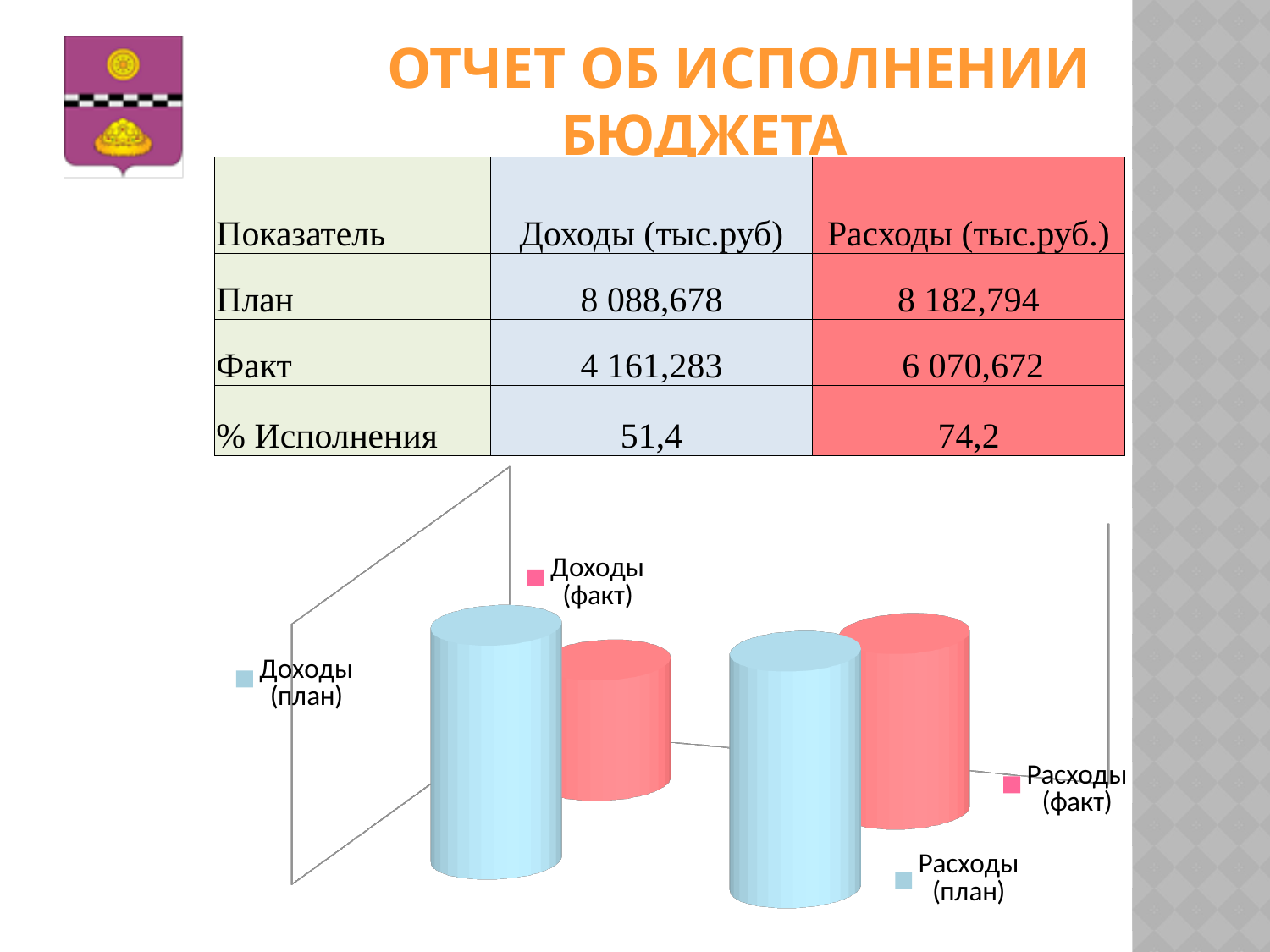
What is the value for Доходы (план) in тыс.руб? 8 088,678 Which is larger, Доходы (план) or Доходы (факт)? Доходы (план) What colour is the bar for Доходы (план)? light blue What is the difference between Расходы (план) and Расходы (факт) in тыс.руб? 2 112,122 Which bar in the chart is the lowest? Доходы (факт) What is the difference between Доходы (план) and Доходы (факт) in тыс.руб? 3 927,395 How many bars are plotted in the chart? 4 What is the value for Расходы (факт) in тыс.руб? 6 070,672 What colour is the bar for Расходы (факт)? pink What is the value for Расходы (план) in тыс.руб? 8 182,794 What kind of chart is shown on the slide? bar chart What is the value for Доходы (факт) in тыс.руб? 4 161,283